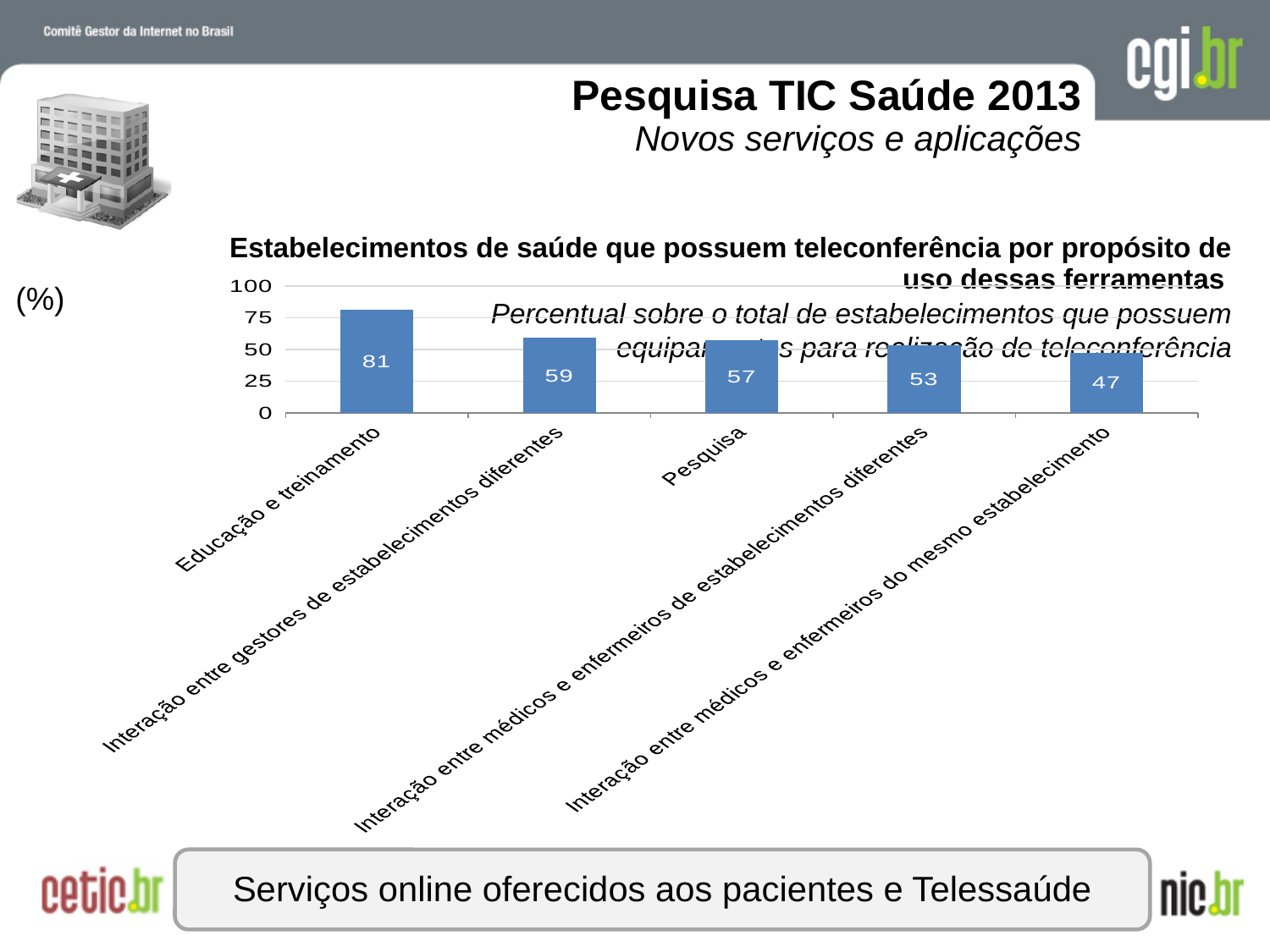
Which is larger, the value for Interação entre gestores de estabelecimentos diferentes or the value for Interação entre médicos e enfermeiros de estabelecimentos diferentes? Interação entre gestores de estabelecimentos diferentes What is the value for Pesquisa? 57 What is the value for Interação entre gestores de estabelecimentos diferentes? 59 What is the value for Educação e treinamento? 81 Is the value for Educação e treinamento greater or less than 75? greater What is the value for Interação entre médicos e enfermeiros do mesmo estabelecimento? 47 What kind of chart is shown on the slide? bar chart How many categories are shown in the chart? 5 Which category has the lowest value? Interação entre médicos e enfermeiros do mesmo estabelecimento Do the values rise or fall from left to right along the x axis? fall Which category has the highest value? Educação e treinamento What is the difference between the values for Educação e treinamento and Pesquisa? 24